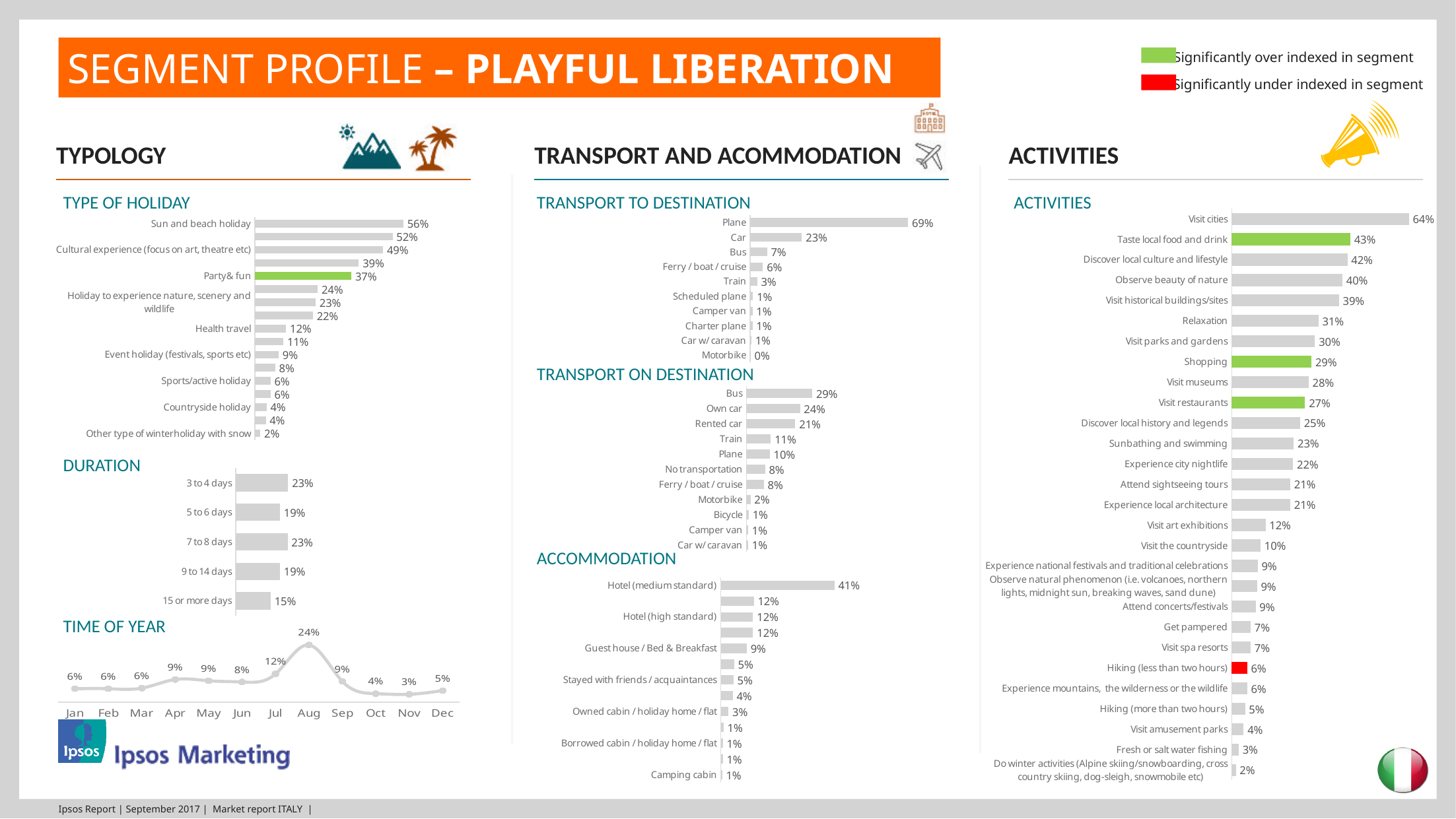
In the Activities chart, which activity has the highest value? Visit cities In the Accommodation chart, what is the value for Hotel (medium standard)? 41% What kind of chart is the Time of Year chart? Line chart In the Time of Year chart, which month has the highest value? Aug In the Type of Holiday chart, what is the value for Sun and beach holiday? 56% In the Transport on Destination chart, which is larger, Own car or Rented car? Own car In the Duration chart, how many categories are shown? 5 In the Duration chart, which category has the lowest value? 15 or more days In the Time of Year chart, what is the value for Nov? 3% In the Activities chart, what is the value for Shopping? 29% In the Transport to Destination chart, what is the difference between Plane and Car? 46% In the Type of Holiday chart, what is the value for Party & fun? 37%